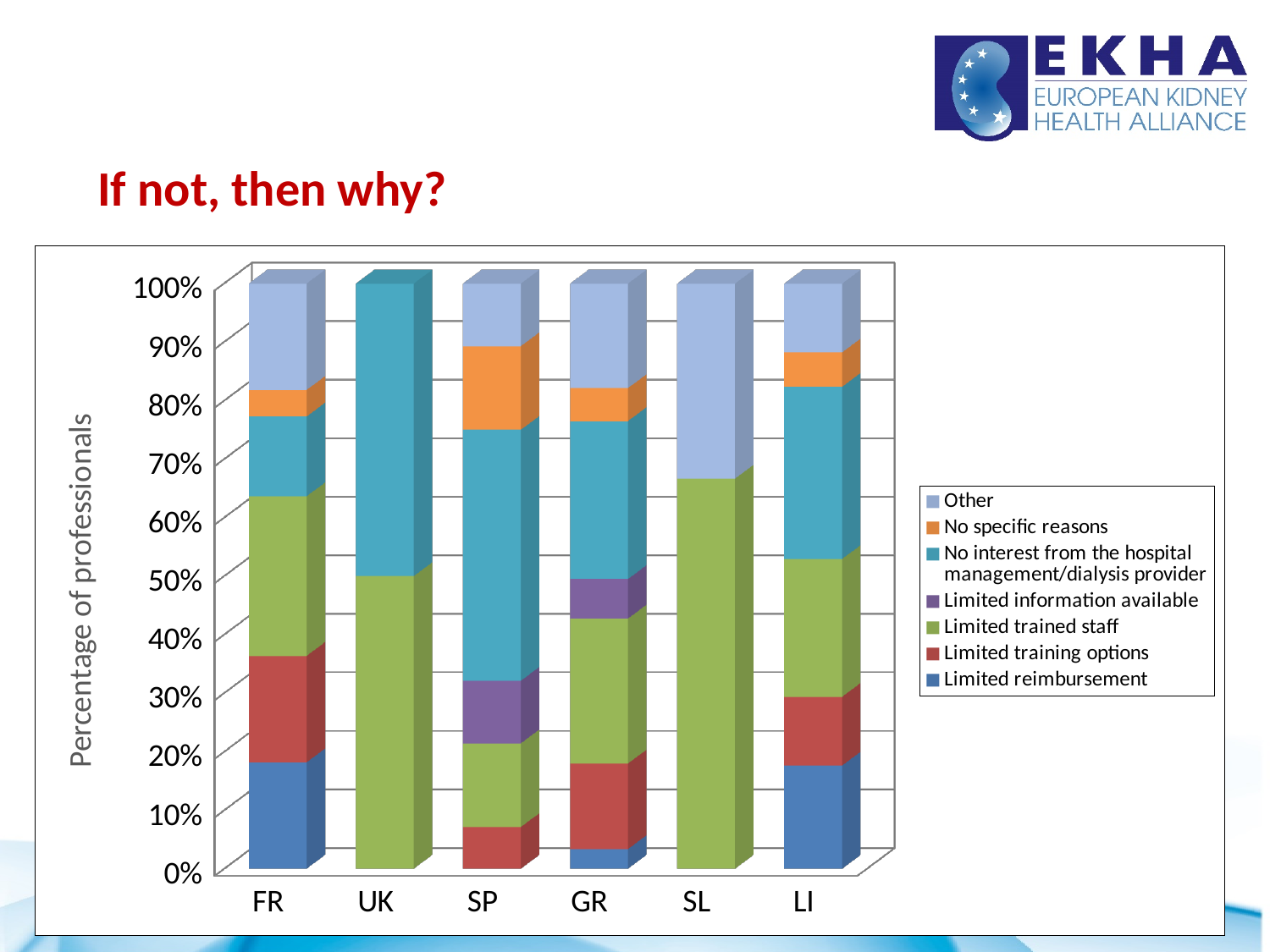
Which is larger: the 'No interest from the hospital management/dialysis provider' share for UK or for FR? UK What kind of chart is shown on the slide? Stacked bar chart How many series does the legend list? 7 What is the label of the vertical axis? Percentage of professionals Is the 'Limited reimbursement' share for FR greater or less than 20%? less Which country has the largest 'Limited trained staff' share? SL What is the total of the stacked bar for FR? 100% Is the 'Other' share for SL greater or less than 30%? greater Is the 'Limited trained staff' share for SL greater or less than 60%? greater What is the title of the slide above the chart? If not, then why? How many countries (categories) are shown on the x axis? 6